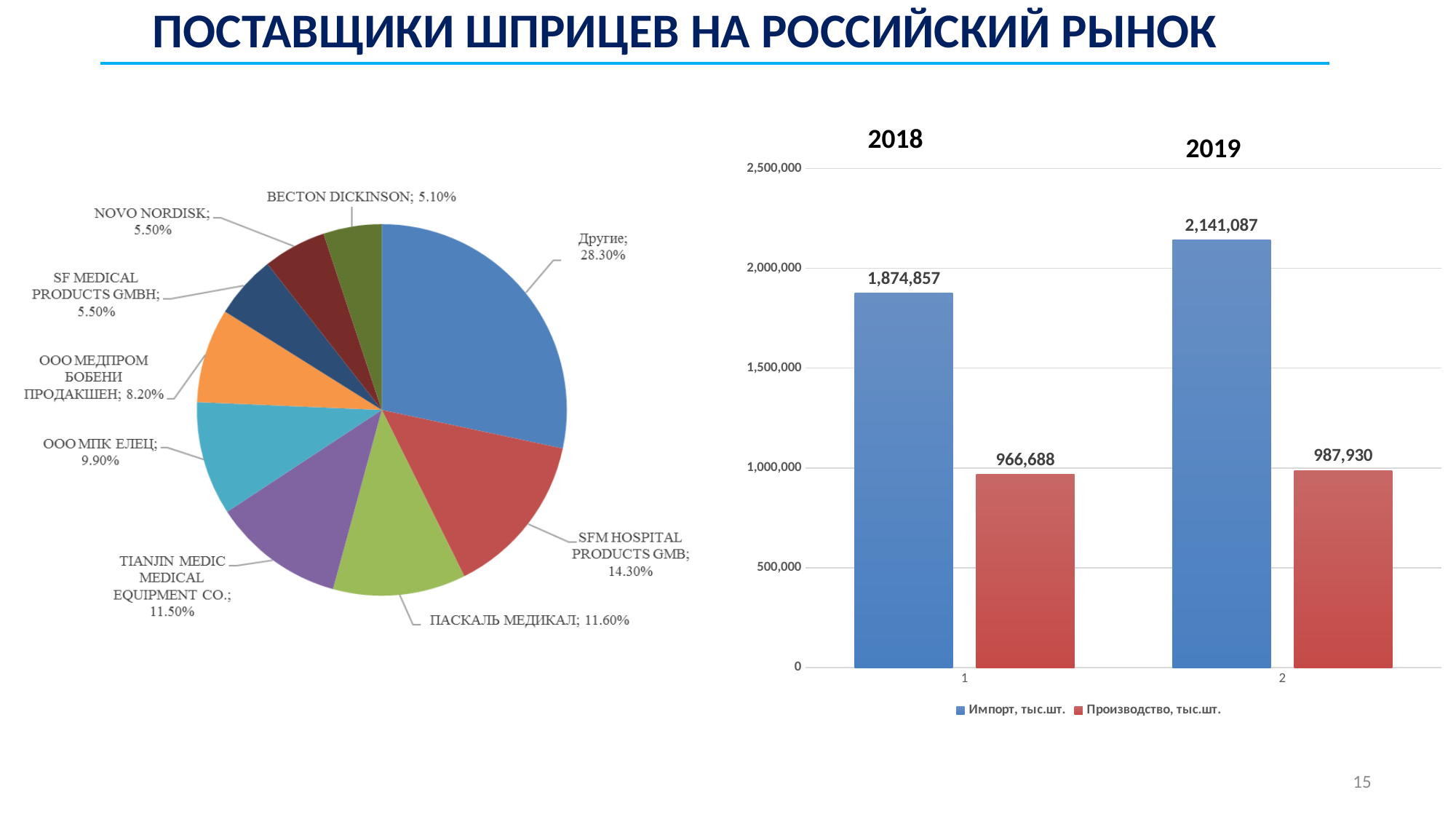
In the bar chart on the right, what is the value of Производство, тыс.шт. for 2018? 966,688 In the bar chart on the right, how many series does the legend list? 2 In the pie chart on the left, what is the difference between the shares of ПАСКАЛЬ МЕДИКАЛ and ООО МПК ЕЛЕЦ? 1.70% In the bar chart on the right, what is the value of Импорт, тыс.шт. for 2019? 2,141,087 In the pie chart on the left, what share does SFM HOSPITAL PRODUCTS GMB hold? 14.30% What type of chart is shown on the right side of the slide? Bar chart In the bar chart on the right, by how much did Импорт, тыс.шт. increase from 2018 to 2019? 266,230 In the bar chart on the right, which is larger in 2019: Импорт, тыс.шт. or Производство, тыс.шт.? Импорт, тыс.шт. In the pie chart on the left, which supplier has the smallest share? BECTON DICKINSON In the pie chart on the left, what share does Другие hold? 28.30% In the pie chart on the left, how many slices are there? 9 In the pie chart on the left, which named supplier (excluding Другие) has the largest share? SFM HOSPITAL PRODUCTS GMB